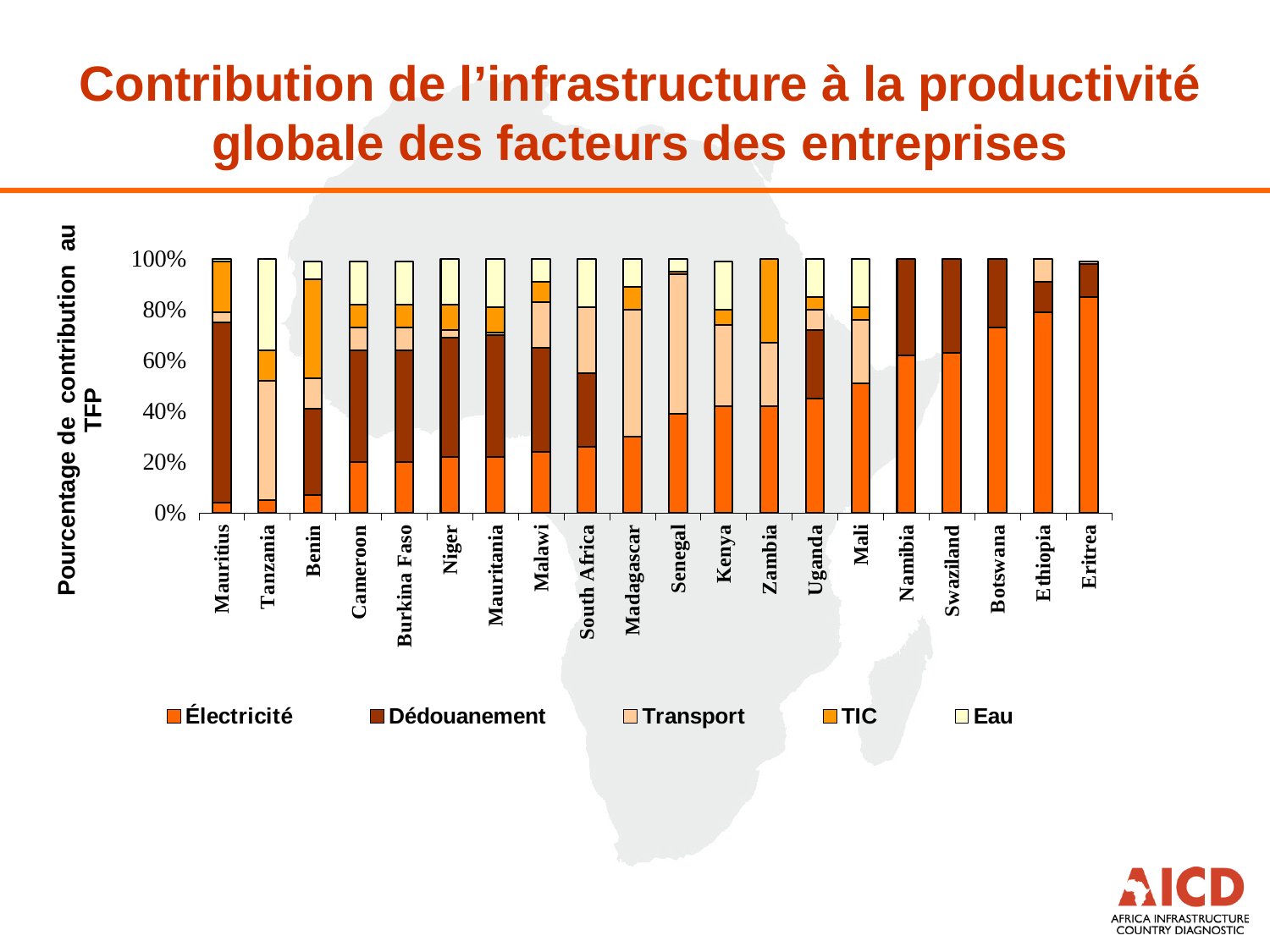
What is the label of the vertical axis? Pourcentage de contribution au TFP Which has the larger Électricité share, Kenya or Cameroon? Kenya Is the Électricité share for Eritrea greater or less than 80%? greater What kind of chart is shown on the slide? Stacked bar chart How many countries are shown on the x axis of the chart? 20 Does the Électricité share generally rise or fall moving from Mauritius on the left to Eritrea on the right? rise Is the Électricité share for Madagascar greater or less than 20%? greater Is the Électricité share for Mauritius greater or less than 20%? less How many series does the legend list? 5 Which series are listed in the chart legend? Électricité, Dédouanement, Transport, TIC, Eau Which country has the largest Électricité share? Eritrea